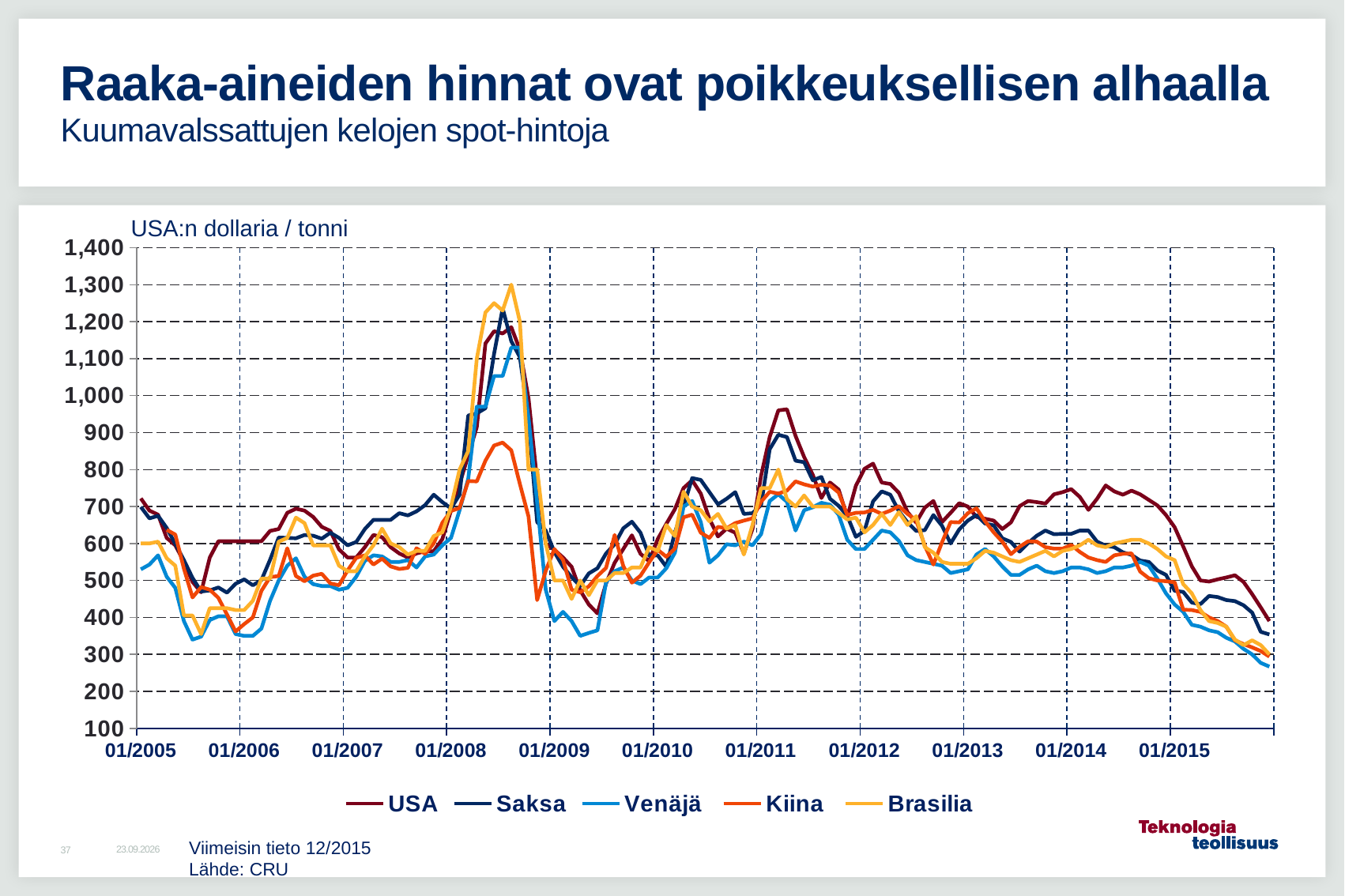
Is the peak value of Brasilia in 2008 greater or less than 1,200? greater Around early 2011, which series reaches a higher peak, USA or Kiina? USA What unit is shown above the y axis? USA:n dollaria / tonni Which series are listed in the legend? USA, Saksa, Venäjä, Kiina, Brasilia Is the value for USA at 01/2005 greater or less than 600? greater How many series does the legend list? 5 Is the value for Venäjä at the end of 2015 greater or less than 300? less Which series has the lowest peak during the 2008 price spike? Kiina What kind of chart is shown on the slide? line chart From 01/2011 to the end of the chart, do USA prices rise or fall overall? fall Which series reaches the highest value anywhere on the chart? Brasilia